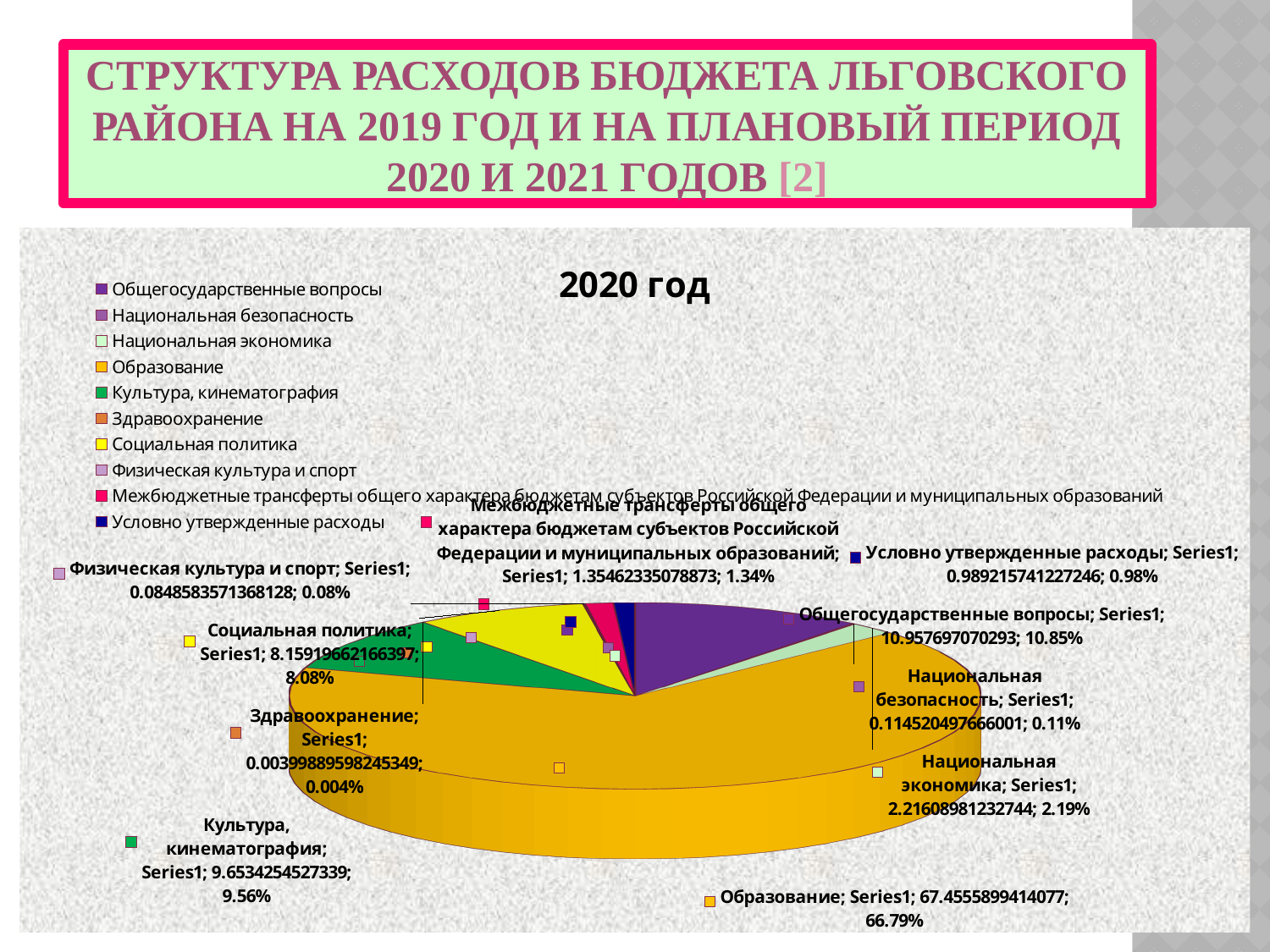
Which category has the smallest slice of the pie? Здравоохранение What percentage share is shown for Национальная безопасность? 0.11% What percentage share is shown for Общегосударственные вопросы? 10.85% What is the difference in percentage points between the shares of Общегосударственные вопросы and Культура, кинематография? 1.29 What percentage share is shown for Социальная политика? 8.08% What kind of chart is shown on the slide? pie chart Which category has the largest slice of the pie? Образование What is the title of the chart? 2020 год Which has a larger share: Национальная экономика or Условно утвержденные расходы? Национальная экономика How many categories does the legend list? 10